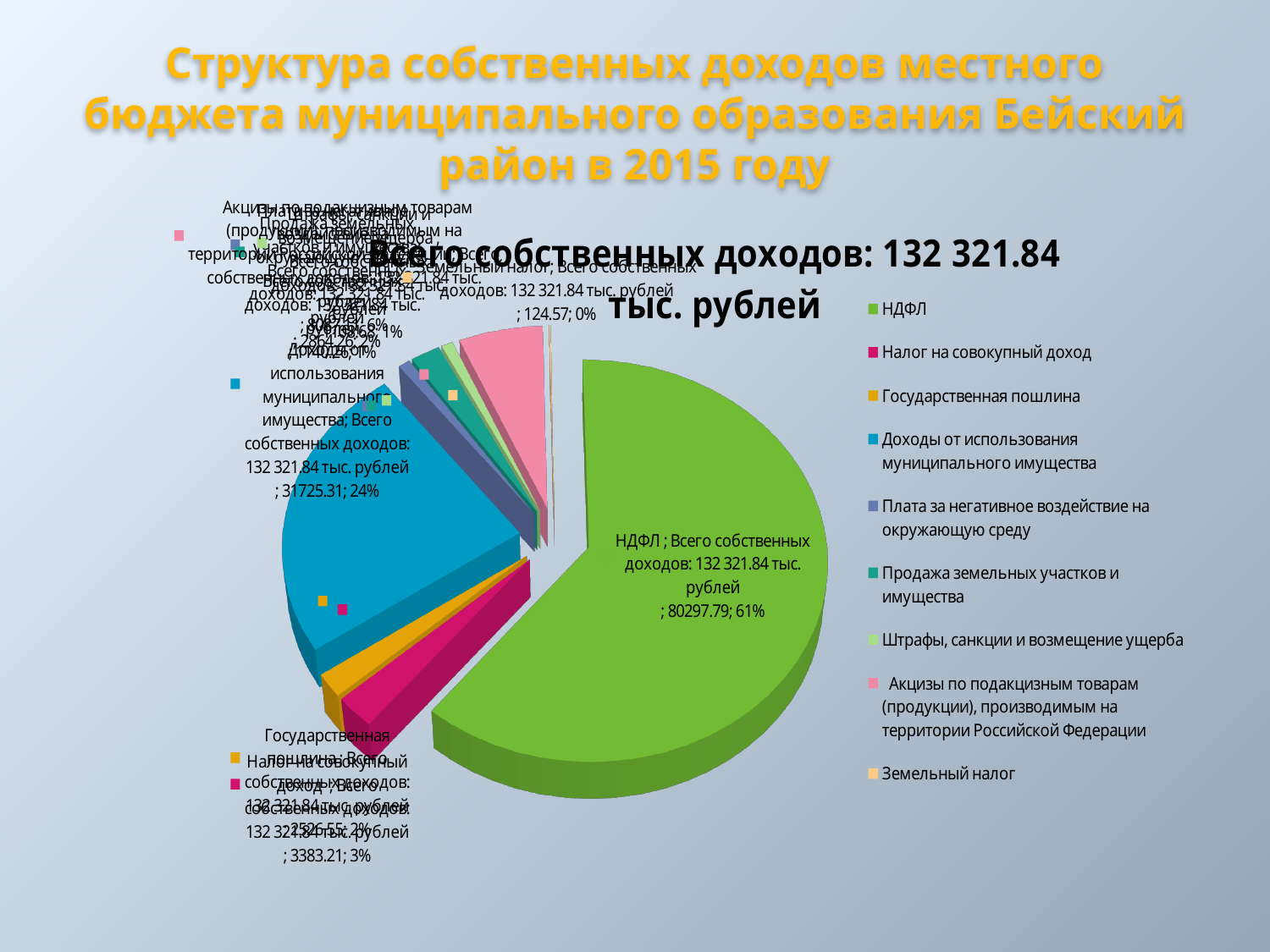
What share of the pie does НДФЛ account for? 61% What kind of chart is shown on the slide? pie chart Which category has the largest slice of the pie? НДФЛ What is the value shown for НДФЛ? 80297.79 What is the title of the pie chart? Всего собственных доходов: 132 321.84 тыс. рублей What is the value shown for Земельный налог? 124.57 What share of the pie does Доходы от использования муниципального имущества account for? 24% What colour is used for НДФЛ in the legend? green How many entries does the legend of the pie chart list? 9 What is the value shown for Доходы от использования муниципального имущества? 31725.31 Which is larger: the slice for НДФЛ or the slice for Доходы от использования муниципального имущества? НДФЛ What is the difference between the value for НДФЛ and the value for Доходы от использования муниципального имущества? 48572.48